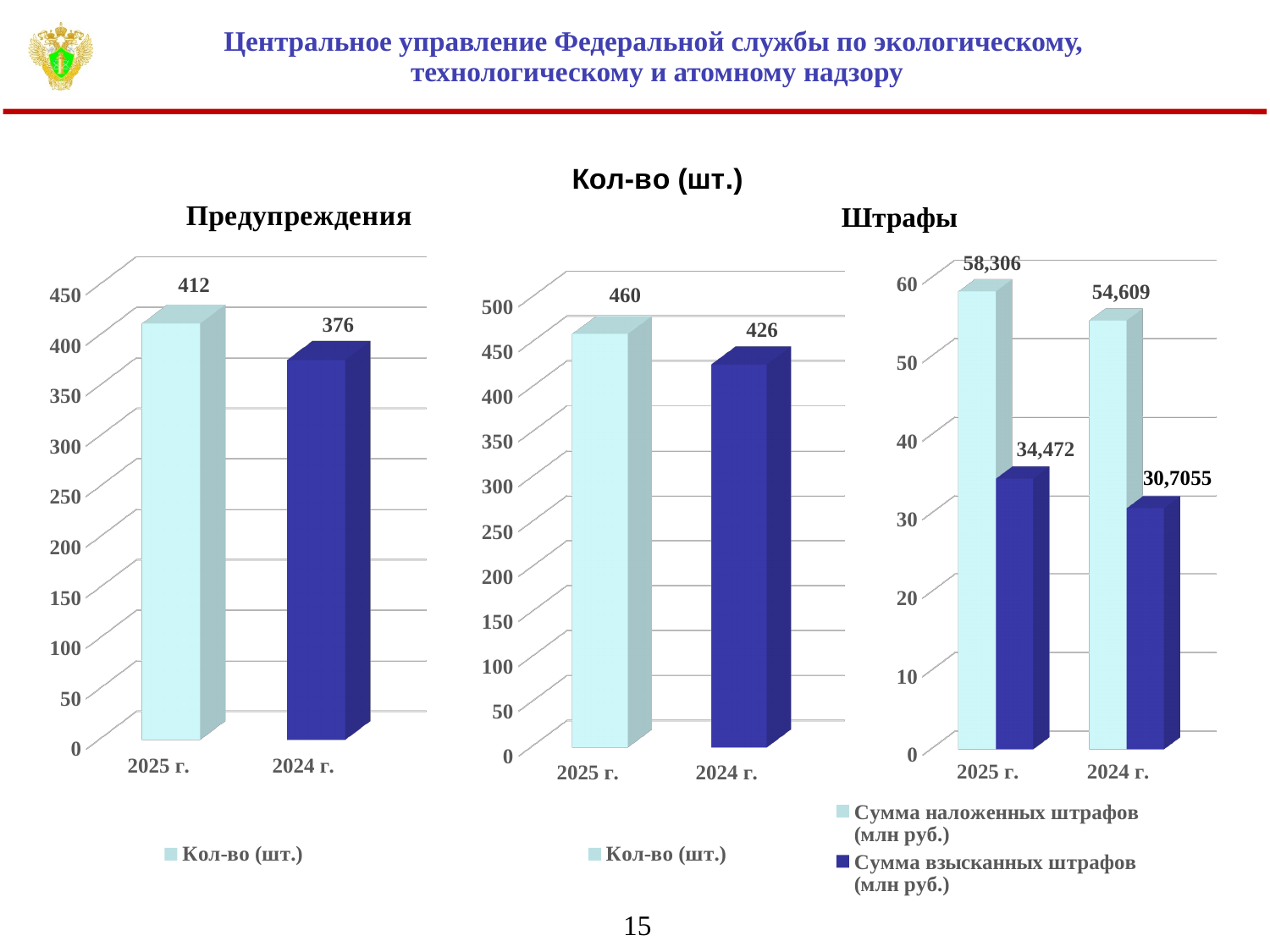
In the 'Предупреждения' chart, what is the value for 2024 г.? 376 In the 'Предупреждения' chart, what is the value for 2025 г.? 412 In the rightmost chart, what is the value of 'Сумма наложенных штрафов (млн руб.)' for 2025 г.? 58,306 In the middle chart, which year has the higher value? 2025 г. In the rightmost chart, how many series does the legend list? 2 In the middle chart, what is the value for 2024 г.? 426 In the middle chart, what is the value for 2025 г.? 460 In the rightmost chart, what is the value of 'Сумма взысканных штрафов (млн руб.)' for 2024 г.? 30,7055 In the rightmost chart, is 'Сумма наложенных штрафов (млн руб.)' for 2024 г. larger or smaller than for 2025 г.? smaller What kind of chart is the 'Предупреждения' chart? bar chart In the 'Предупреждения' chart, what is the difference between the 2025 г. and 2024 г. values? 36 In the middle chart, what is the difference between the 2025 г. and 2024 г. values? 34